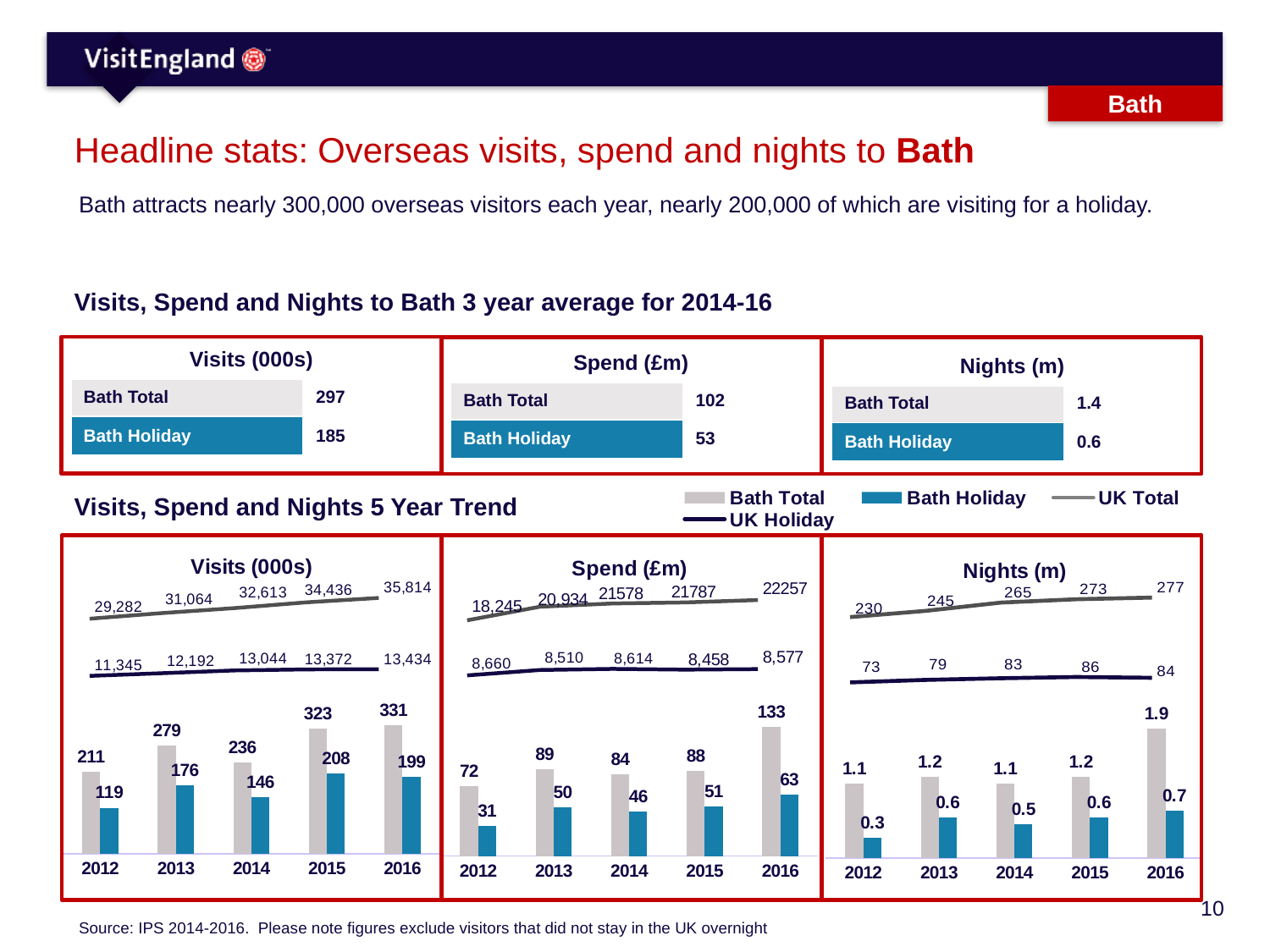
In the Nights (m) 5 year trend chart, what is the UK Holiday value for 2015? 86 How many years are shown on the x axis of the Nights (m) 5 year trend chart? 5 How many series does the legend for the 5 Year Trend charts list? 4 In the Visits (000s) 5 year trend chart, which year has the highest Bath Total value? 2016 In the Visits (000s) 5 year trend chart, what is the difference between the Bath Total and Bath Holiday values for 2013? 103 In the Nights (m) 5 year trend chart, what is the UK Total value for 2014? 265 What kind of chart is used for the Bath Total and Bath Holiday values in the Visits (000s) 5 year trend chart? Bar chart In the Spend (£m) 5 year trend chart, is the Bath Total value for 2016 larger than the Bath Total value for 2015? Yes In the Spend (£m) 5 year trend chart, which year has the lowest Bath Holiday value? 2012 In the Spend (£m) 5 year trend chart, what is the Bath Holiday value for 2012? 31 In the Visits (000s) 5 year trend chart, what is the Bath Total value for 2016? 331 In the Visits (000s) 5 year trend chart, does the UK Total line rise or fall from 2012 to 2016? Rise